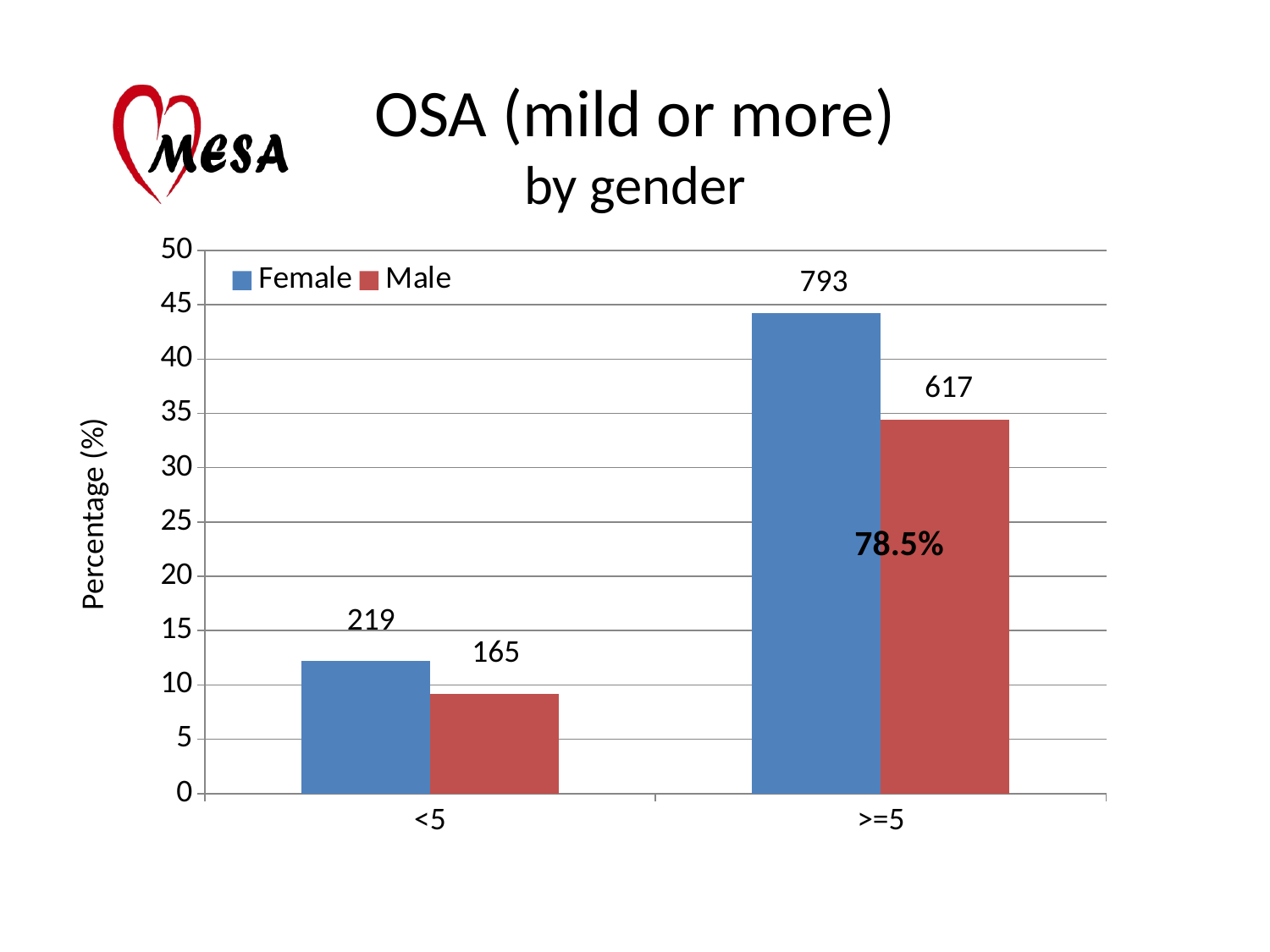
Which bar is the shortest in the chart? Male, <5 How many categories are shown on the x axis? 2 What data label is printed above the Female bar for the >=5 category? 793 What kind of chart is shown on the slide? bar chart What data label is printed above the Female bar for the <5 category? 219 Is the percentage for Male in the <5 category greater or less than 10? less How many series does the legend list? 2 What data label is printed above the Male bar for the >=5 category? 617 What percentage annotation is printed in bold on the >=5 bars? 78.5% Is the percentage for Female in the >=5 category greater or less than 40? greater Which bar is the tallest in the chart? Female, >=5 In the >=5 category, which is larger, the Female bar or the Male bar? Female